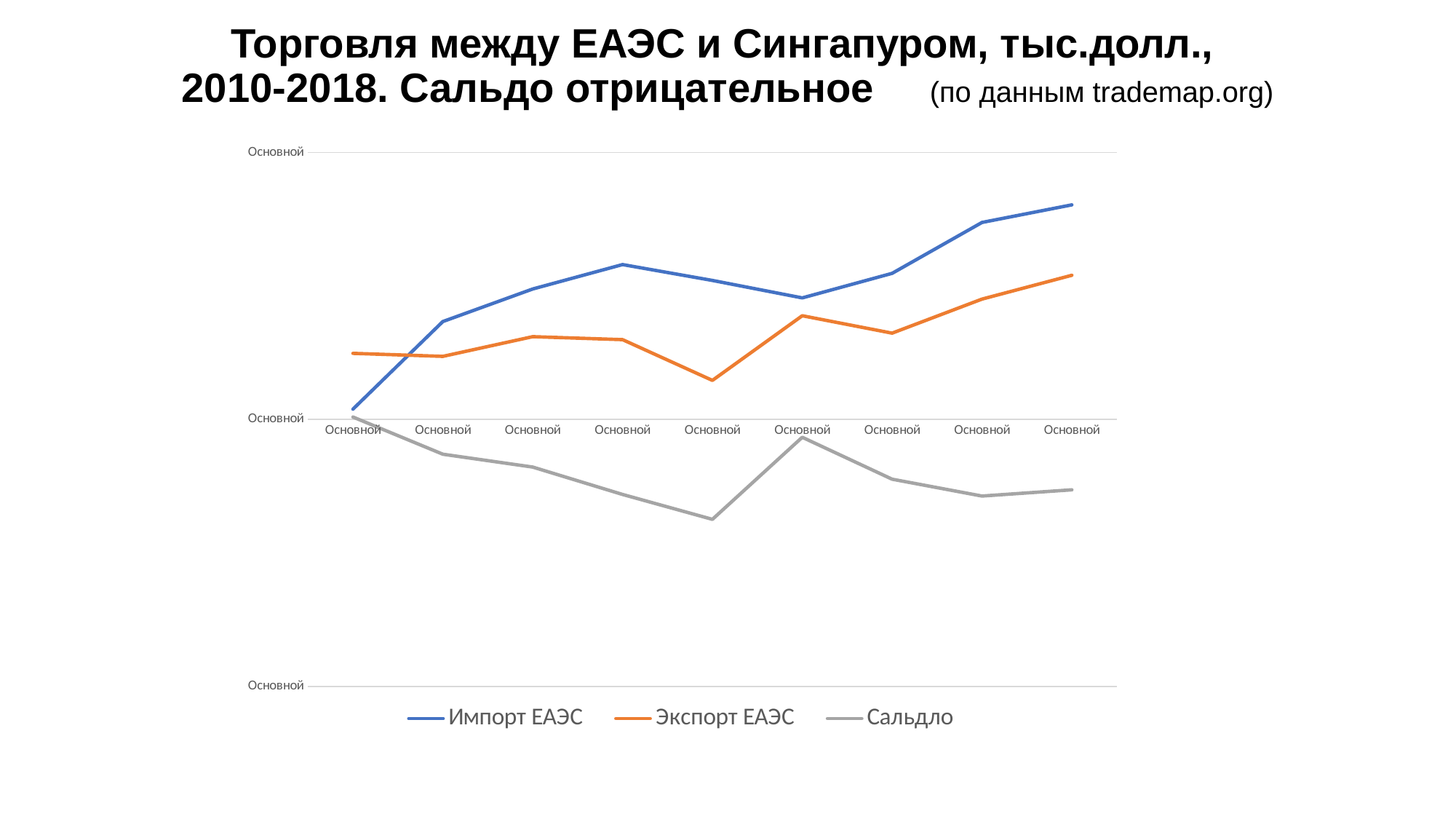
What kind of chart is shown on the slide? line chart Does the Импорт ЕАЭС line rise or fall overall from the first point to the last point? rise Which series is plotted entirely below the other two series? Сальдло Does the Сальдло line rise or fall overall from the first point to the last point? fall Which series has the lowest value at the last point on the x axis? Сальдло Which series has the highest value at the last point on the x axis? Импорт ЕАЭС How many data points does each line have along the x axis? 9 What is the title of the chart on the slide? Торговля между ЕАЭС и Сингапуром, тыс.долл., 2010-2018. Сальдо отрицательное At the last point on the x axis, which is larger: Импорт ЕАЭС or Экспорт ЕАЭС? Импорт ЕАЭС How many series does the legend list? 3 What colour is the Экспорт ЕАЭС line? orange At the first point on the x axis, which is larger: Импорт ЕАЭС or Экспорт ЕАЭС? Экспорт ЕАЭС